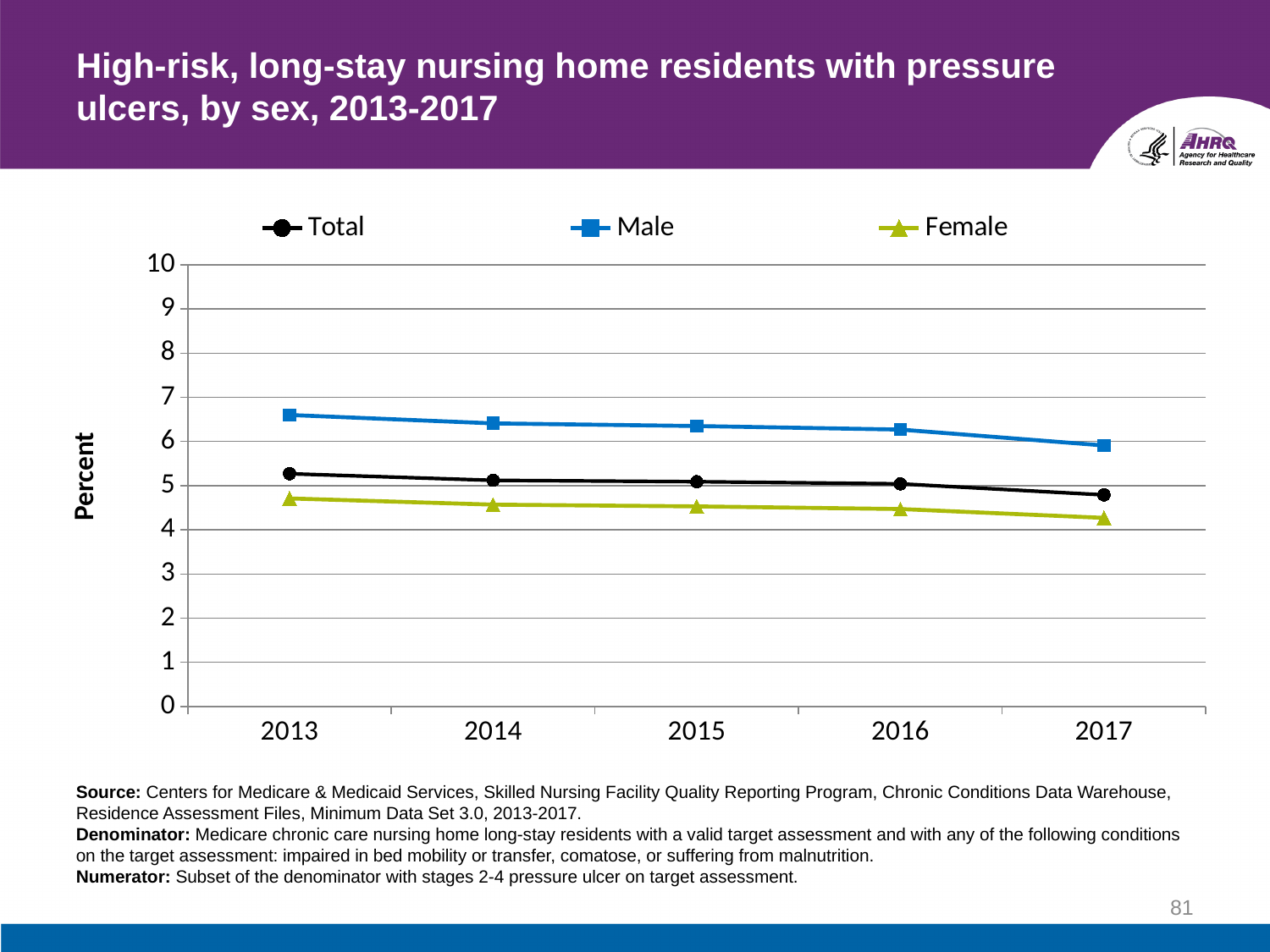
Is the Male value for 2013 greater or less than 6? greater Is the Total value for 2017 greater or less than 5? less Which is larger in 2017, the Male value or the Female value? Male What kind of chart is shown on the slide? line chart How many years are plotted along the x axis? 5 Is the Female value for 2013 greater or less than 5? less Which series has the highest values across all years? Male What is the label on the y axis? Percent How many series does the legend list? 3 Do the Total values rise or fall from 2013 to 2017? fall Which series has the lowest values across all years? Female In which year is the Male value highest? 2013